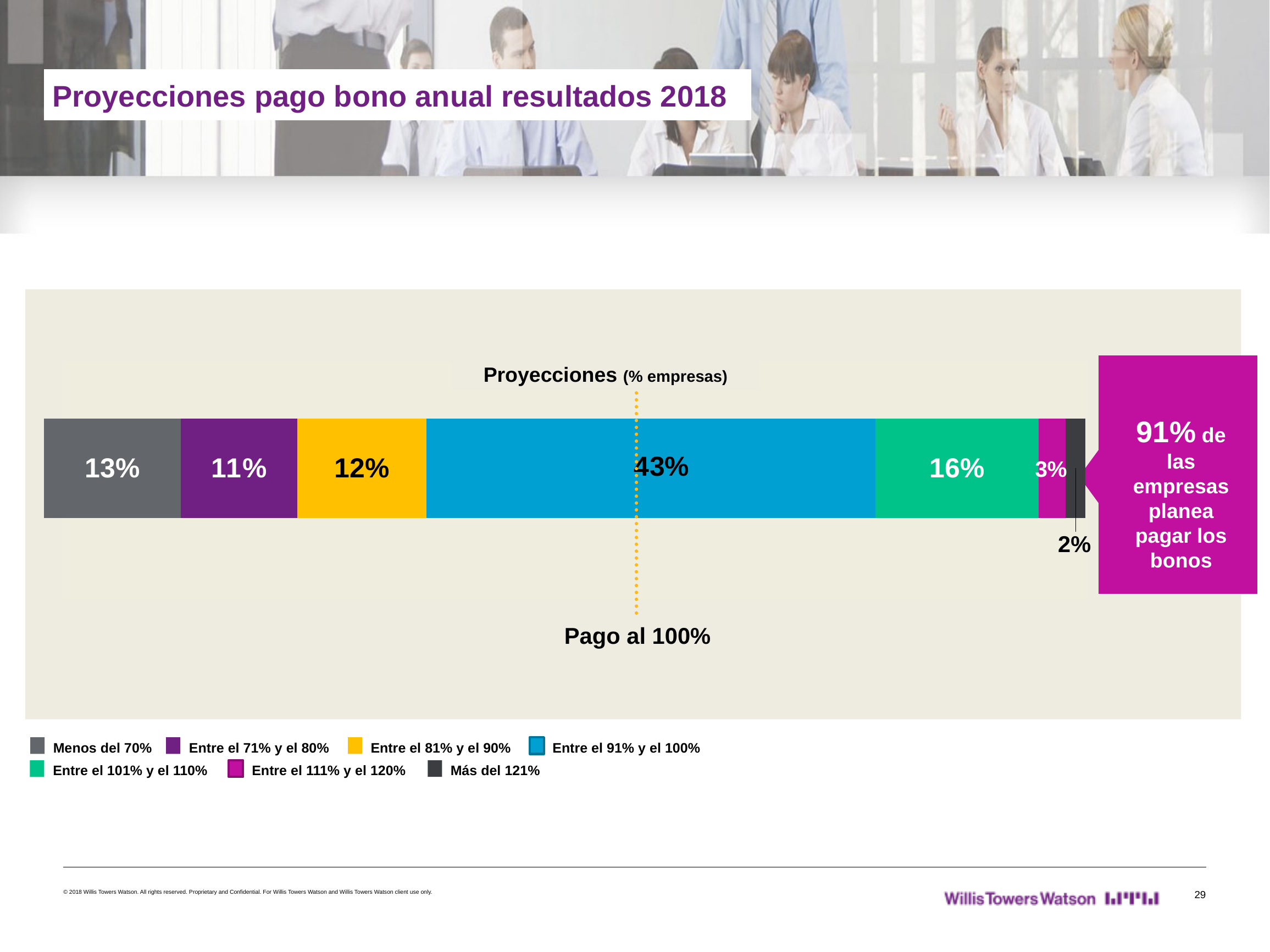
What percentage of companies project a bonus payout of 'Entre el 91% y el 100%'? 43% What is the difference between the share for 'Entre el 91% y el 100%' and the share for 'Entre el 101% y el 110%'? 27% Which payout range has the smallest share of companies? Más del 121% What is the label on the dotted vertical line through the bar? Pago al 100% Which has a larger share of companies: 'Entre el 71% y el 80%' or 'Entre el 81% y el 90%'? Entre el 81% y el 90% What percentage of companies project a bonus payout of 'Menos del 70%'? 13% What percentage of companies project a bonus payout of 'Entre el 101% y el 110%'? 16% Which payout range has the largest share of companies? Entre el 91% y el 100% What kind of chart is shown on the slide? Stacked bar chart How many entries does the legend list? 7 What percentage of companies project a bonus payout of 'Más del 121%'? 2% How many payout ranges (segments) are shown in the bar? 7